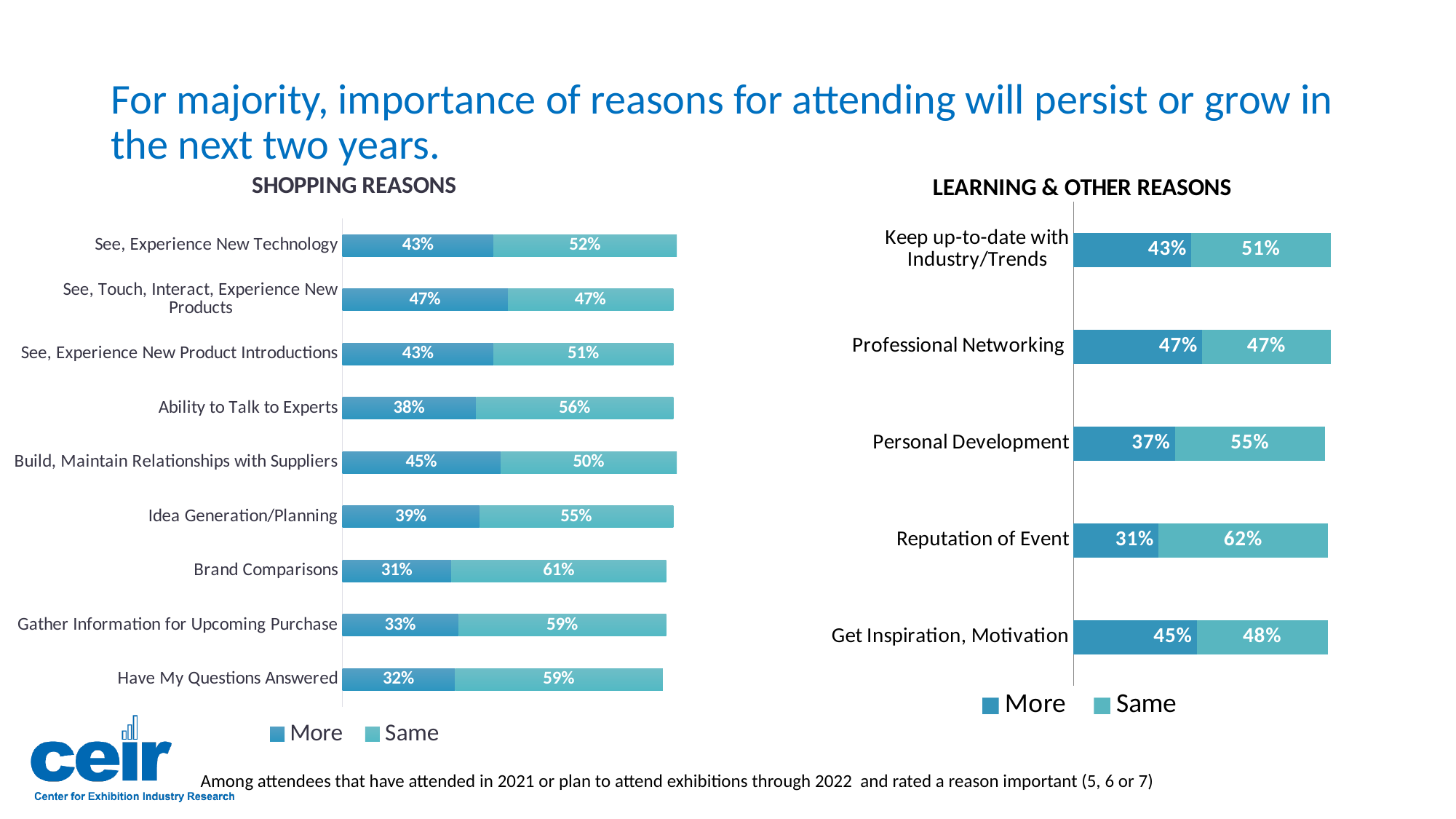
In the LEARNING & OTHER REASONS chart, which is larger for Personal Development: the 'More' value or the 'Same' value? Same How many series does the legend of the SHOPPING REASONS chart list? 2 In the LEARNING & OTHER REASONS chart, what is the total of the 'More' and 'Same' values for Get Inspiration, Motivation? 93% In the SHOPPING REASONS chart, what is the difference between the 'Same' and 'More' values for Brand Comparisons? 30% In the LEARNING & OTHER REASONS chart, which category has the lowest 'More' value? Reputation of Event In the LEARNING & OTHER REASONS chart, what is the 'Same' value for Reputation of Event? 62% How many categories are shown in the SHOPPING REASONS chart? 9 In the SHOPPING REASONS chart, which category has the highest 'Same' value? Brand Comparisons In the SHOPPING REASONS chart, what is the 'More' value for Ability to Talk to Experts? 38% How many categories are shown in the LEARNING & OTHER REASONS chart? 5 What kind of chart is the LEARNING & OTHER REASONS chart? Stacked bar chart What are the two legend entries in the SHOPPING REASONS chart? More and Same